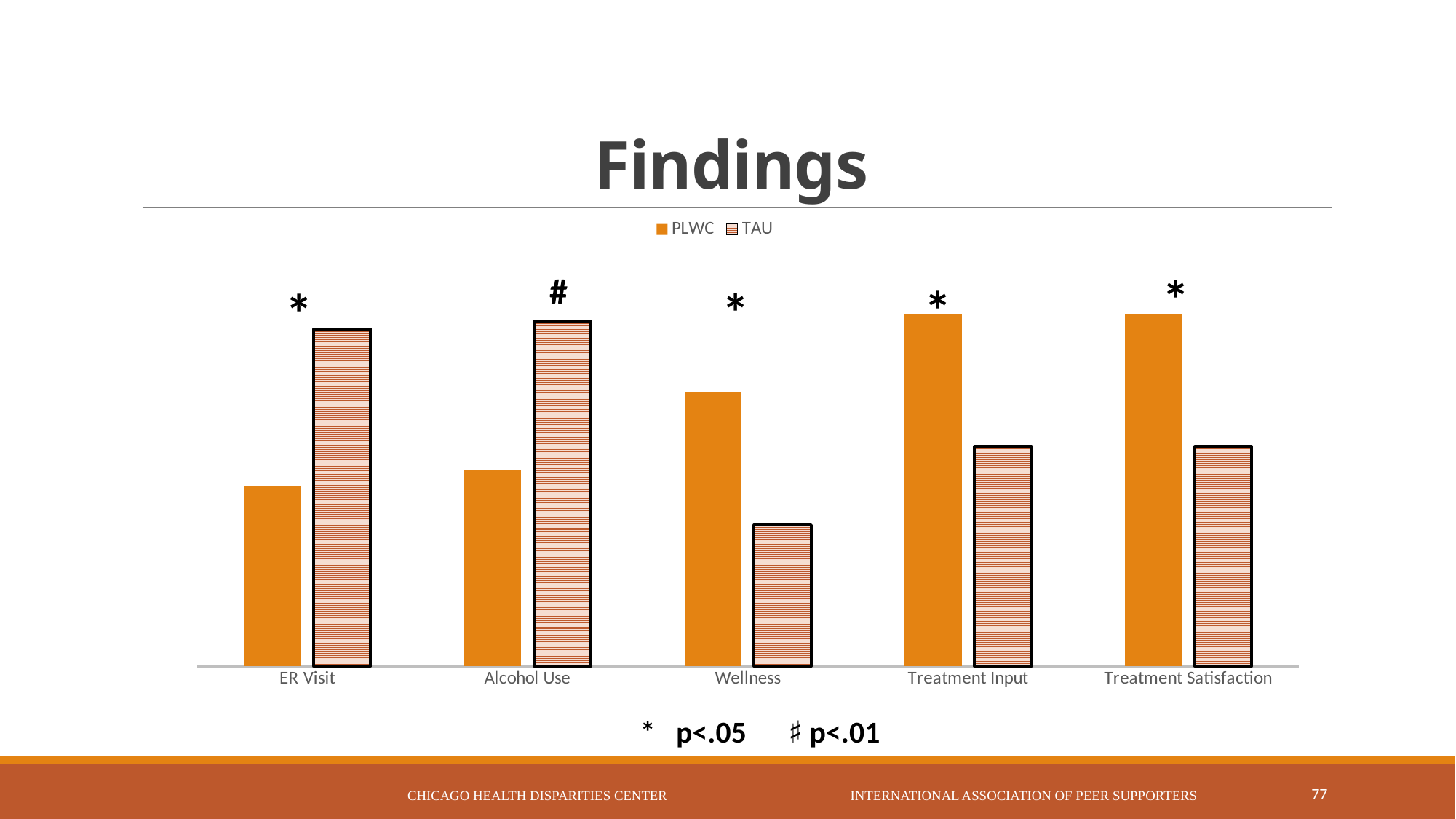
What is the title of the slide containing the chart? Findings For Wellness, which series has the larger value, PLWC or TAU? PLWC How many series does the chart's legend list? 2 For Alcohol Use, which series has the larger value, PLWC or TAU? TAU For ER Visit, which series has the larger value, PLWC or TAU? TAU Which category has the lowest PLWC value? ER Visit What type of chart is shown on the slide? Bar chart What are the two series named in the chart's legend? PLWC and TAU Which category has the lowest TAU value? Wellness How many categories are shown along the x axis of the chart? 5